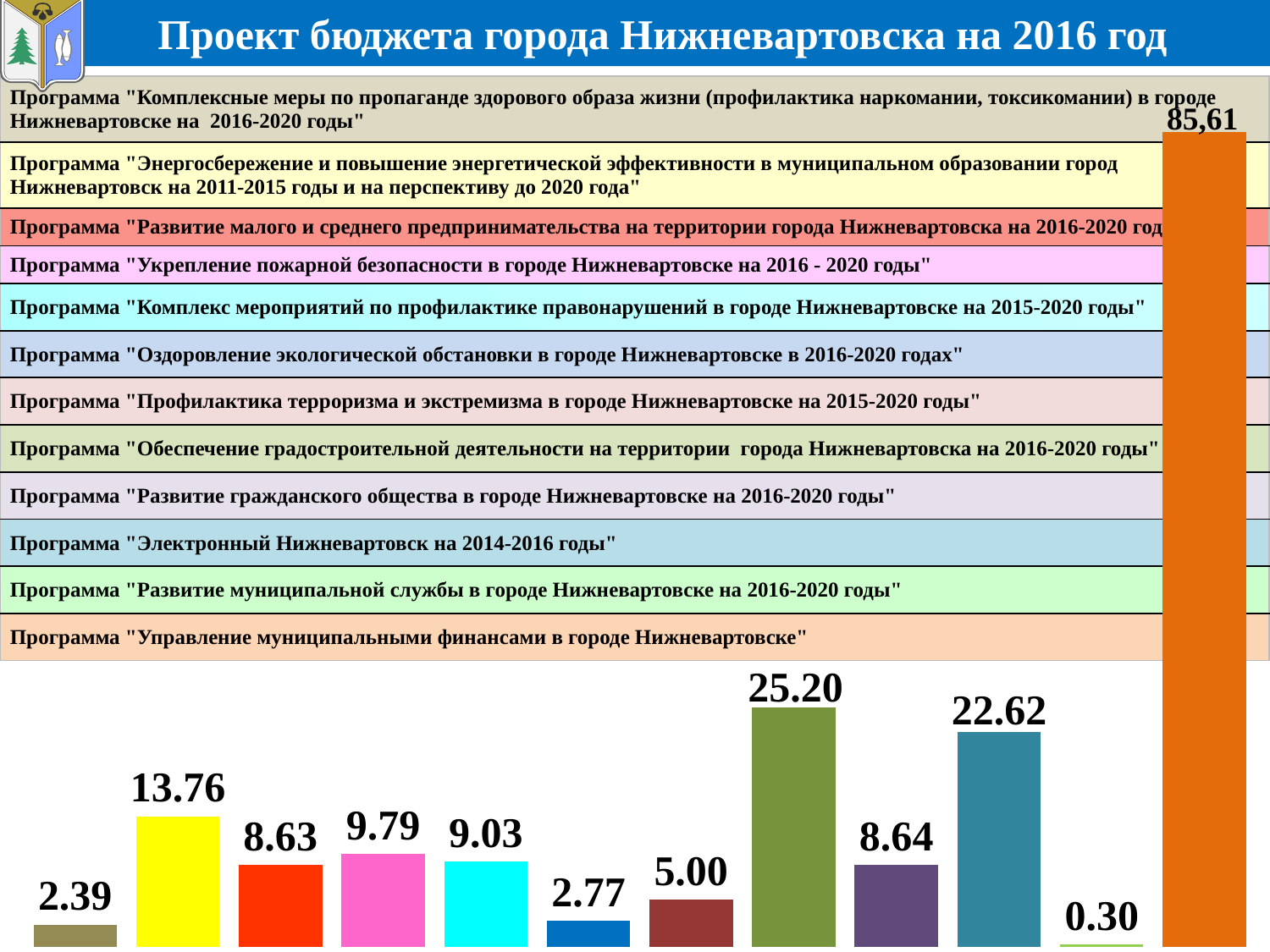
What is the title of the slide? Проект бюджета города Нижневартовска на 2016 год What is the difference between the yellow bar (13.76) and the first bar on the left (2.39)? 11.37 Which program has the lowest value in the chart? Развитие муниципальной службы в городе Нижневартовске на 2016-2020 годы What is the value shown for the program "Управление муниципальными финансами в городе Нижневартовске" (the orange bar)? 85,61 What is the difference between the olive green bar (25.20) and the teal bar (22.62)? 2.58 What is the value shown for the program "Энергосбережение и повышение энергетической эффективности..." (the yellow bar)? 13.76 Which is larger: the pink bar (Укрепление пожарной безопасности) or the cyan bar (Комплекс мероприятий по профилактике правонарушений)? Укрепление пожарной безопасности (9.79) What type of chart is shown on the slide? Bar chart What is the value shown for the program "Профилактика терроризма и экстремизма в городе Нижневартовске на 2015-2020 годы" (the dark red bar)? 5.00 How many bars are plotted in the chart? 12 Which program has the highest value in the chart? Управление муниципальными финансами в городе Нижневартовске What is the value shown for the program "Электронный Нижневартовск на 2014-2016 годы" (the teal bar)? 22.62